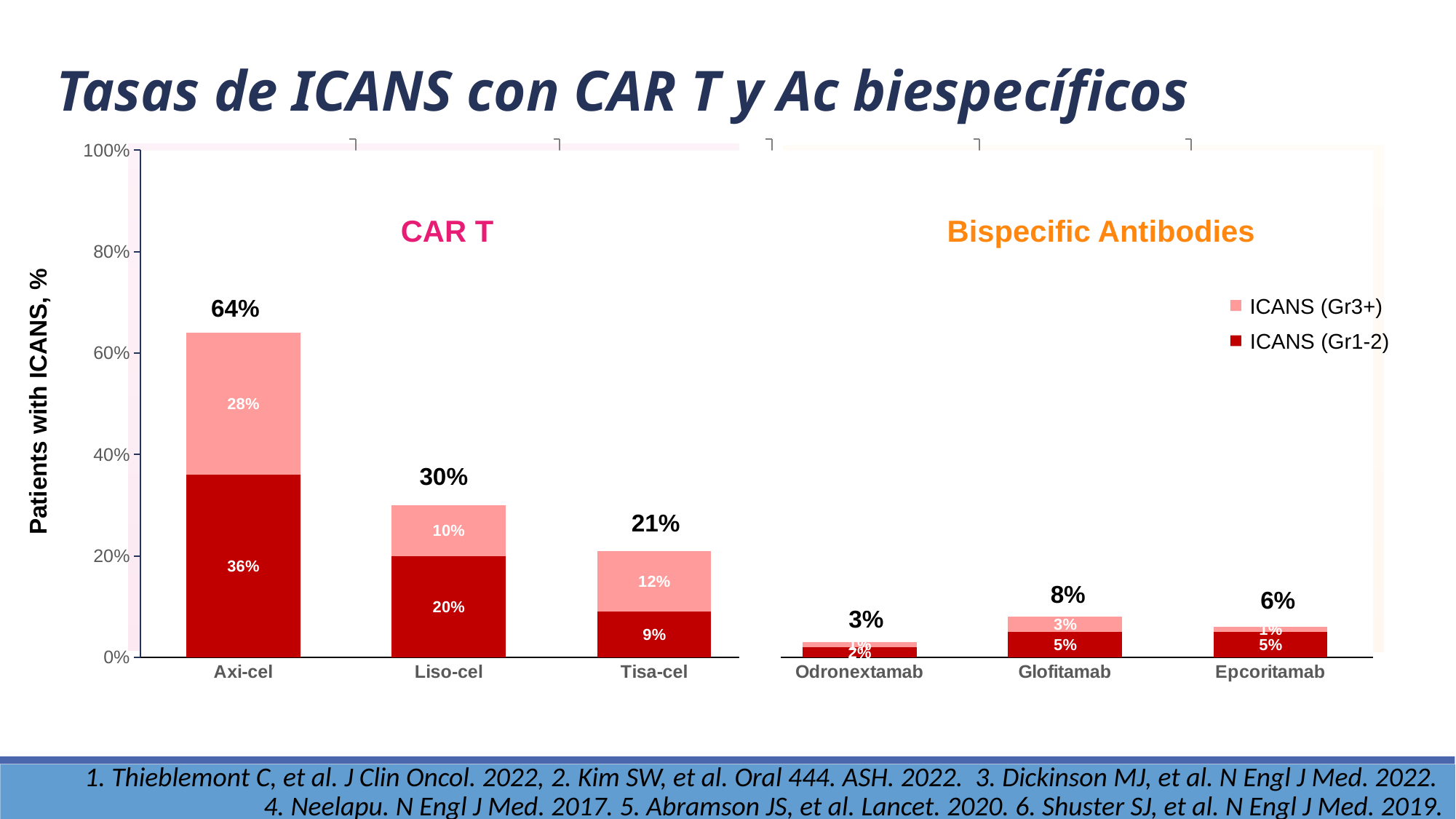
Which category has the highest total ICANS rate? Axi-cel What is the difference between the total ICANS rates of Axi-cel and Liso-cel? 34% What is the ICANS (Gr1-2) value for Liso-cel? 20% Which has a higher total ICANS rate, Glofitamab or Epcoritamab? Glofitamab What is the ICANS (Gr3+) value for Tisa-cel? 12% What is the ICANS (Gr1-2) value for Glofitamab? 5% What kind of chart is shown on the slide? Stacked bar chart How many categories are shown on the x axis? 6 Which category has the lowest total ICANS rate? Odronextamab What is the label of the y axis? Patients with ICANS, % What is the total percentage of patients with ICANS for Axi-cel? 64% How many series does the legend list? 2